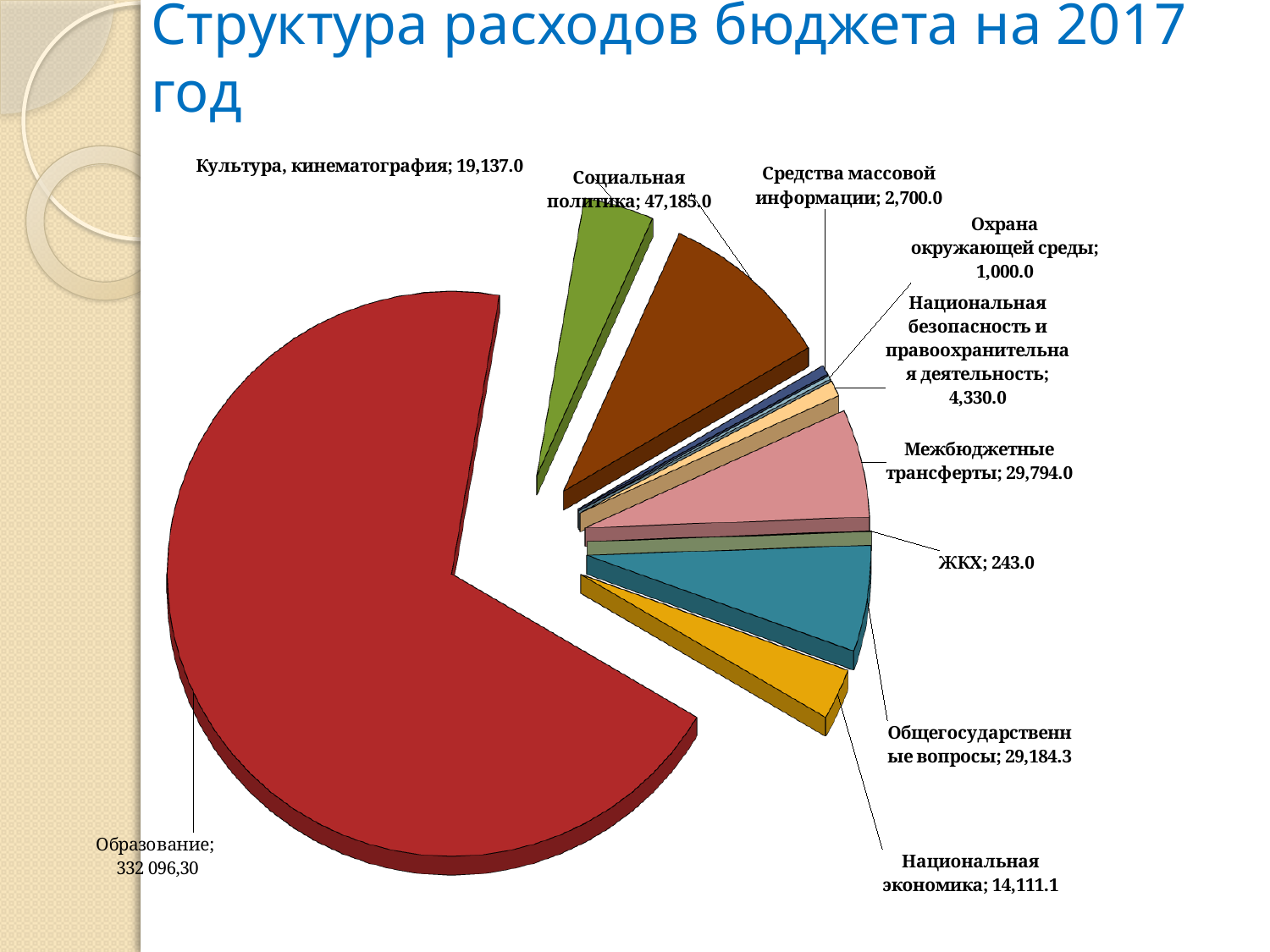
What kind of chart is shown on the slide? Pie chart What is the value for Межбюджетные трансферты? 29,794.0 What is the value for ЖКХ? 243.0 Which category has the largest slice of the pie? Образование Which is larger, Культура, кинематография or Национальная экономика? Культура, кинематография What is the value for Национальная экономика? 14,111.1 What is the value for Социальная политика? 47,185.0 Which category has the smallest value? ЖКХ What is the difference between Общегосударственные вопросы and Национальная экономика? 15,073.2 How many categories are shown in the pie chart? 10 What is the difference between Социальная политика and Межбюджетные трансферты? 17,391.0 What is the title of the slide? Структура расходов бюджета на 2017 год